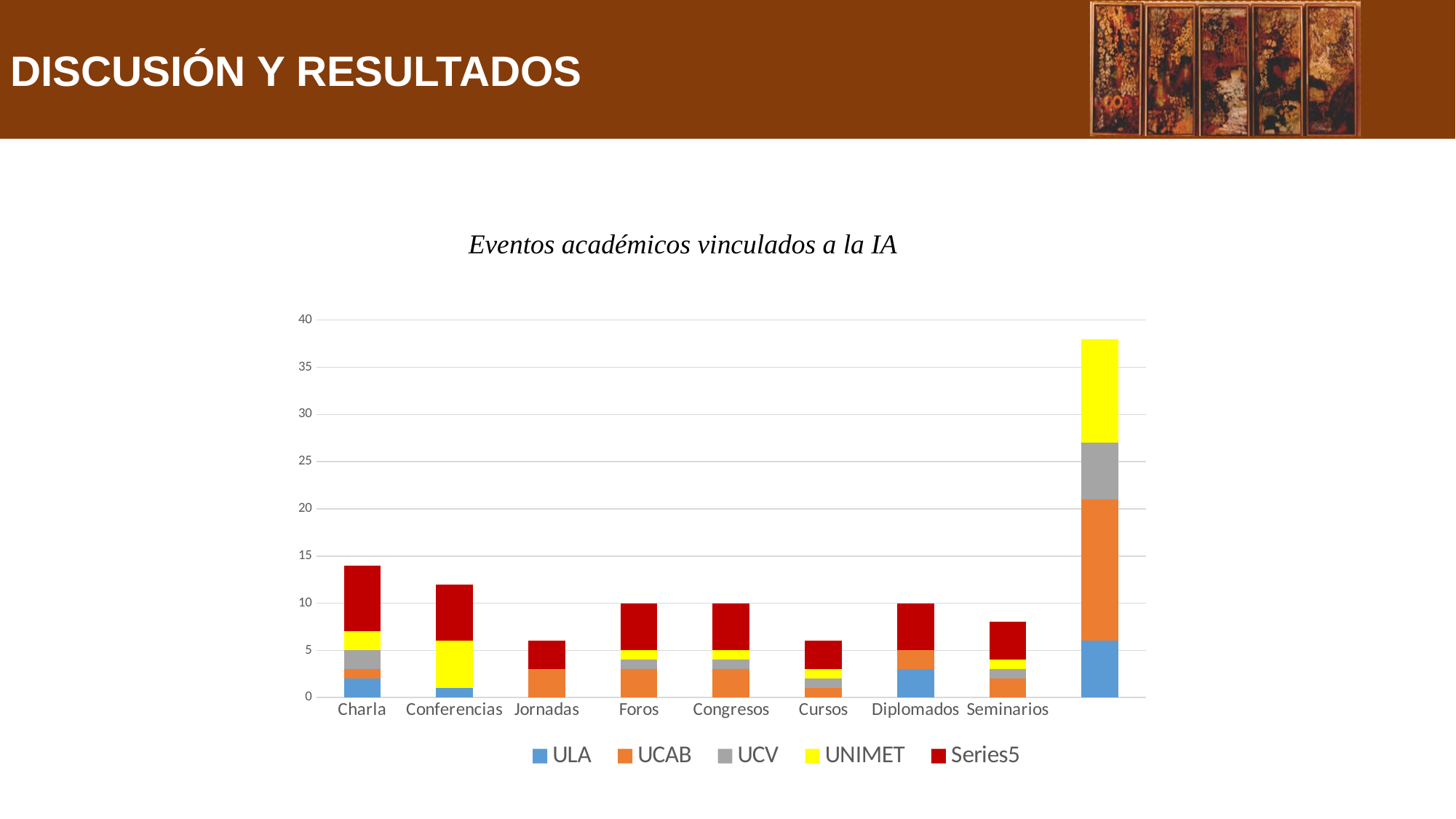
Is the total stacked bar for Jornadas greater or less than 10? less Is the total stacked bar for Charla greater or less than 10? greater Which has the taller stacked bar, Charla or Conferencias? Charla Is the total stacked bar for Cursos greater or less than 10? less What is the title of the chart? Eventos académicos vinculados a la IA Which series is shown in yellow in the legend? UNIMET Which has the taller stacked bar, Foros or Cursos? Foros Among the labeled categories, which has the tallest stacked bar? Charla How many series does the legend list? 5 What kind of chart is shown on the slide? Stacked bar chart